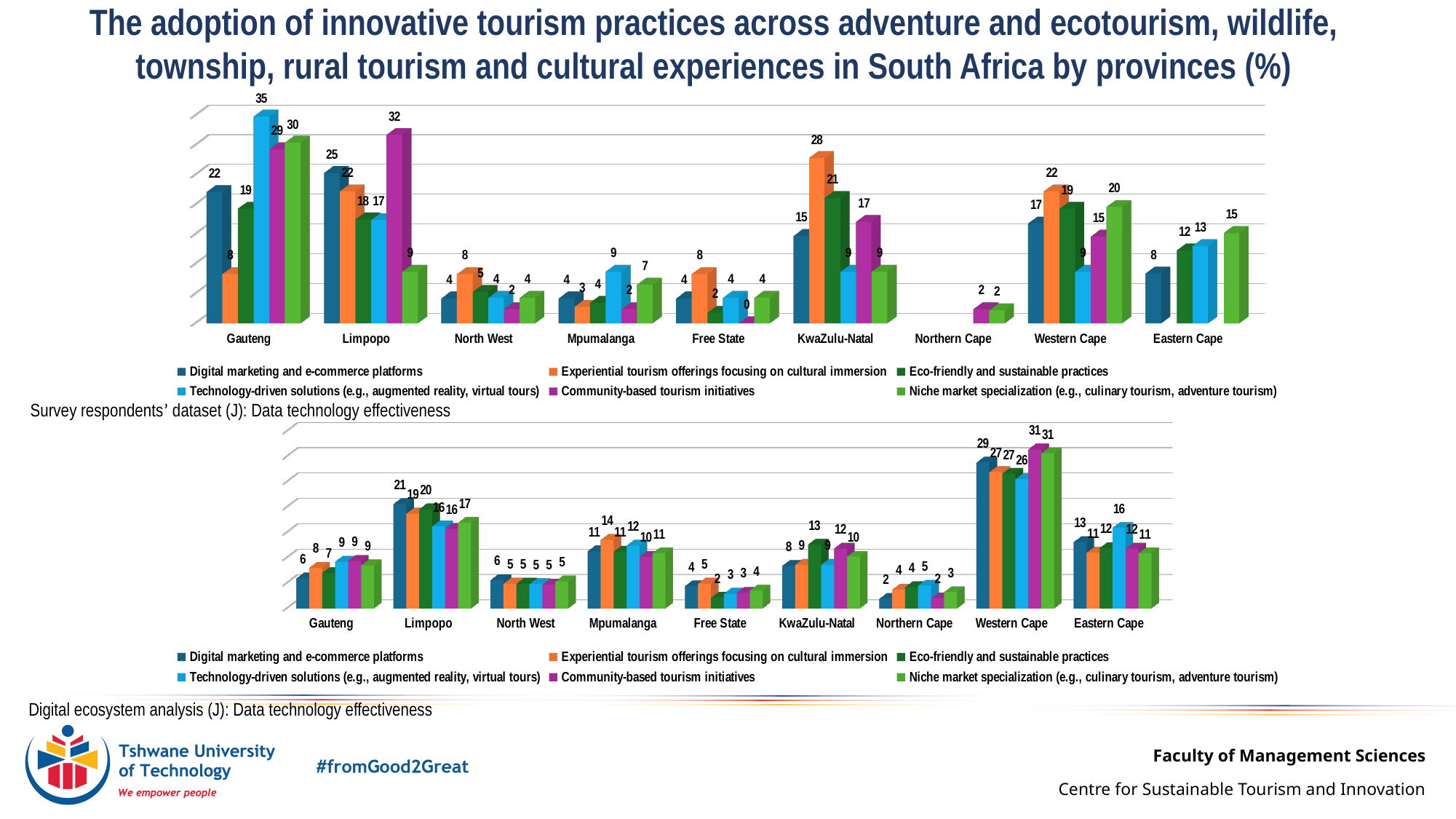
Which colour represents Experiential tourism offerings focusing on cultural immersion in the legend of the top chart? Orange In the bottom chart (Digital ecosystem analysis), what is the difference between the Technology-driven solutions values for Eastern Cape and Limpopo? 0 In the bottom chart (Digital ecosystem analysis), which province has the lowest value for Digital marketing and e-commerce platforms? Northern Cape In the top chart (Survey respondents' dataset), what is the value for Community-based tourism initiatives in Limpopo? 32 In the top chart (Survey respondents' dataset), what is the value for Technology-driven solutions in Gauteng? 35 In the bottom chart (Digital ecosystem analysis), what is the value for Community-based tourism initiatives in Western Cape? 31 In the top chart (Survey respondents' dataset), what is the difference between the Digital marketing and e-commerce platforms values for Limpopo and Gauteng? 3 In the top chart (Survey respondents' dataset), which province has the highest value for Experiential tourism offerings focusing on cultural immersion? KwaZulu-Natal In the top chart (Survey respondents' dataset), which is larger: Niche market specialization in Western Cape or in Eastern Cape? Western Cape How many series does the legend of the bottom chart (Digital ecosystem analysis) list? 6 How many provinces are shown on the x axis of the bottom chart (Digital ecosystem analysis)? 9 What type of chart is the bottom chart (Digital ecosystem analysis)? Bar chart